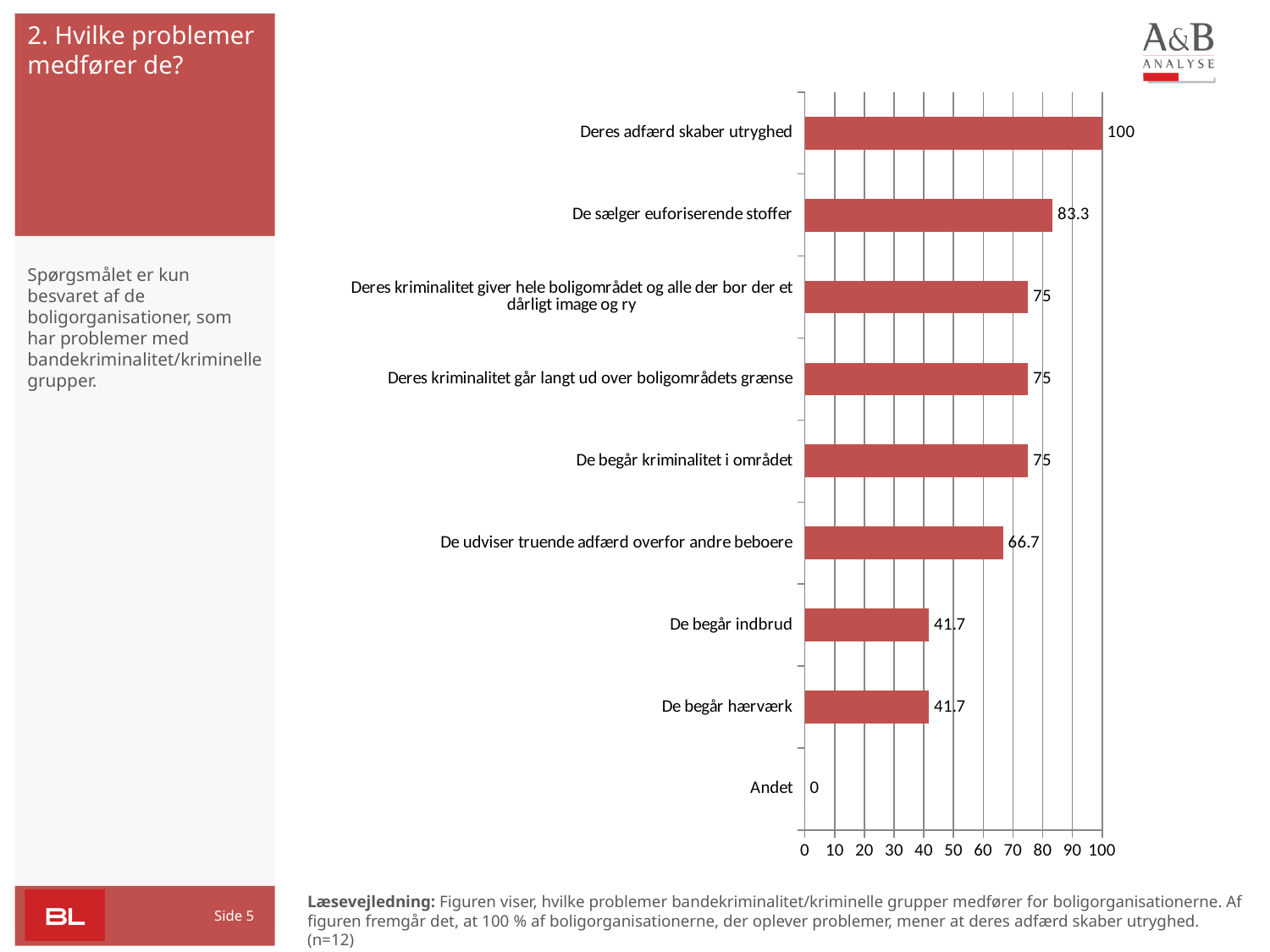
Which category has the lowest value? Andet What is the value for "Andet"? 0 Which category has the highest value? Deres adfærd skaber utryghed What is the difference between the values for "Deres adfærd skaber utryghed" and "De sælger euforiserende stoffer"? 16.7 What is the value for "Deres adfærd skaber utryghed"? 100 What is the value for "De begår hærværk"? 41.7 What is the value for "De sælger euforiserende stoffer"? 83.3 What is the value for "De udviser truende adfærd overfor andre beboere"? 66.7 Which is larger: the value for "De begår kriminalitet i området" or the value for "De begår indbrud"? De begår kriminalitet i området What kind of chart is shown on the slide? Bar chart What is the difference between the values for "De udviser truende adfærd overfor andre beboere" and "De begår indbrud"? 25 How many categories are shown in the chart? 9